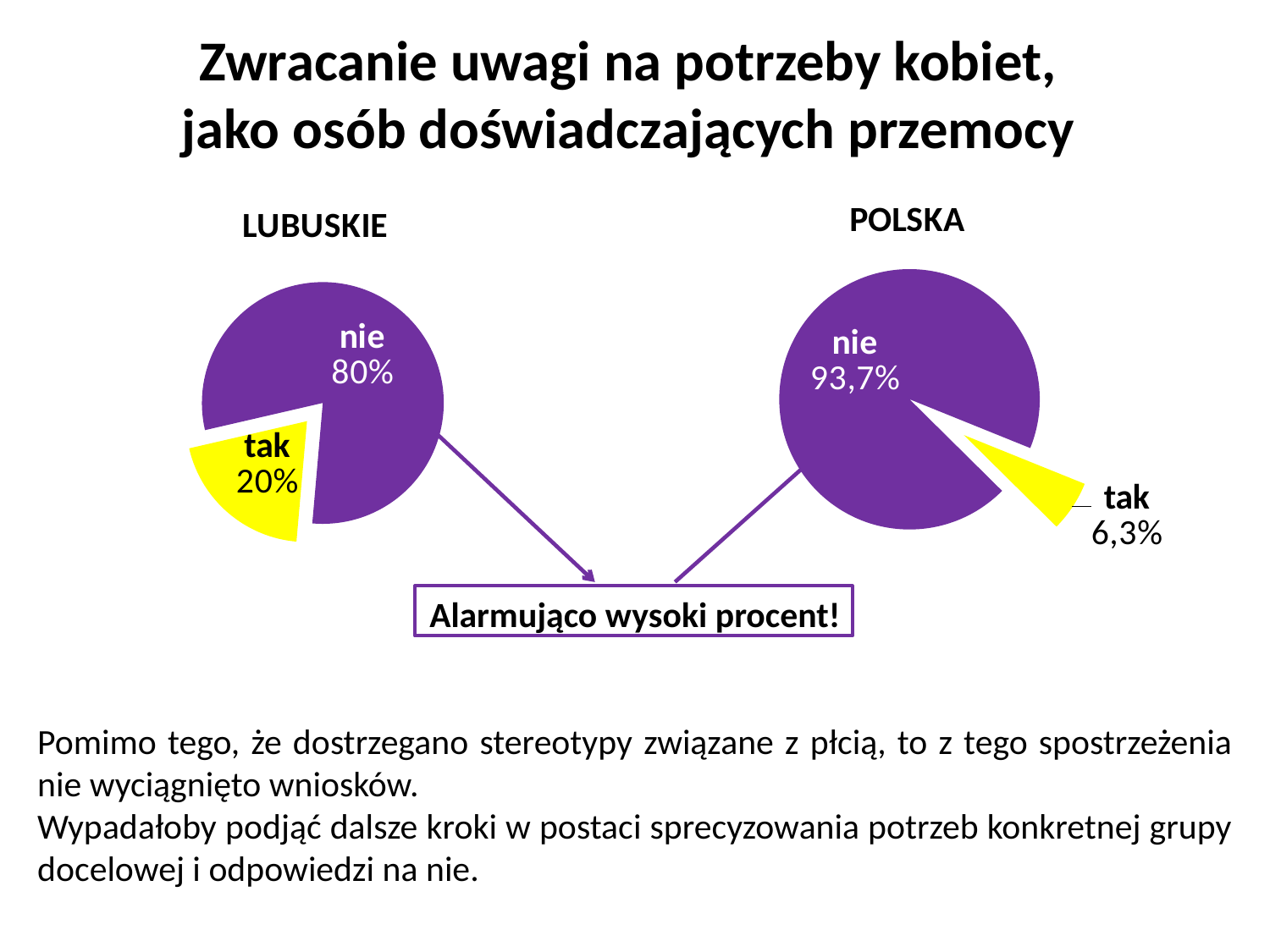
In the LUBUSKIE chart, what share is labelled "tak"? 20% How many slices does the POLSKA chart have? 2 In the LUBUSKIE chart, what share is labelled "nie"? 80% In the POLSKA chart, which slice is the smallest? tak In the LUBUSKIE chart, what is the difference between the "nie" and "tak" shares? 60% In the LUBUSKIE chart, which slice is the largest? nie What is the difference between the "nie" share in the POLSKA chart and the "nie" share in the LUBUSKIE chart? 13,7% In the POLSKA chart, what share is labelled "tak"? 6,3% What colour is the "tak" slice in the POLSKA chart? yellow In the POLSKA chart, what share is labelled "nie"? 93,7% What kind of chart is the LUBUSKIE chart? pie chart Which is larger: the "tak" share in the LUBUSKIE chart or the "tak" share in the POLSKA chart? LUBUSKIE